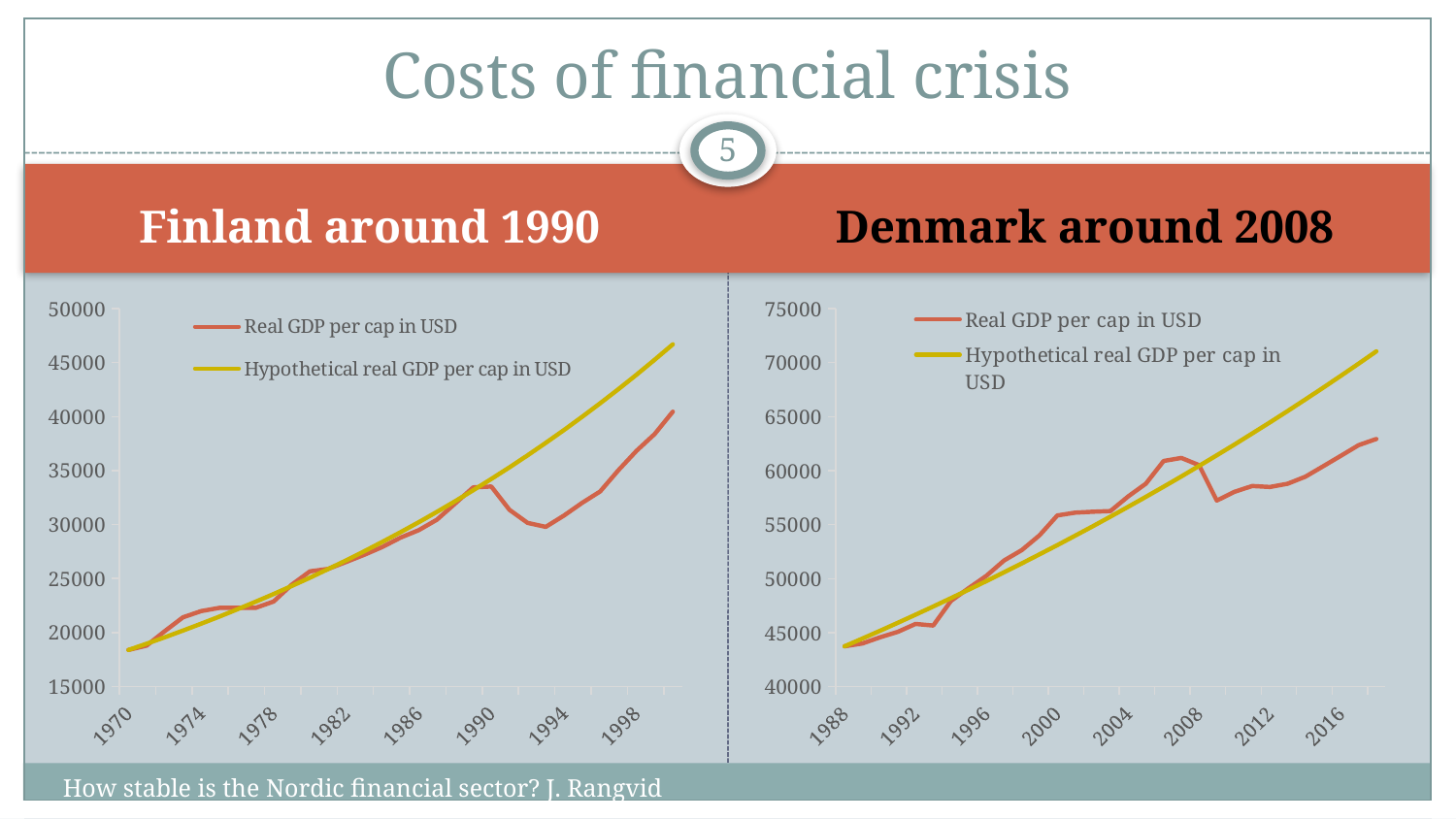
In the 'Finland around 1990' chart, which series is higher at the end of the period: Real GDP per cap in USD or Hypothetical real GDP per cap in USD? Hypothetical real GDP per cap in USD In the 'Finland around 1990' chart, what are the two series named in the legend? Real GDP per cap in USD; Hypothetical real GDP per cap in USD In the 'Finland around 1990' chart, is the value of Real GDP per cap in USD in 1970 greater or less than 20000? less In the 'Denmark around 2008' chart, which series is higher in 2016: Real GDP per cap in USD or Hypothetical real GDP per cap in USD? Hypothetical real GDP per cap in USD In the 'Denmark around 2008' chart, is the value of Real GDP per cap in USD in 1988 greater or less than 45000? less How many series does the legend of the 'Denmark around 2008' chart list? 2 In the 'Denmark around 2008' chart, does the Hypothetical real GDP per cap in USD series rise or fall from 1988 to the end of the period? rise In the 'Finland around 1990' chart, is the value of Real GDP per cap in USD in 1998 greater or less than 35000? greater What kind of chart is the 'Finland around 1990' chart? line chart